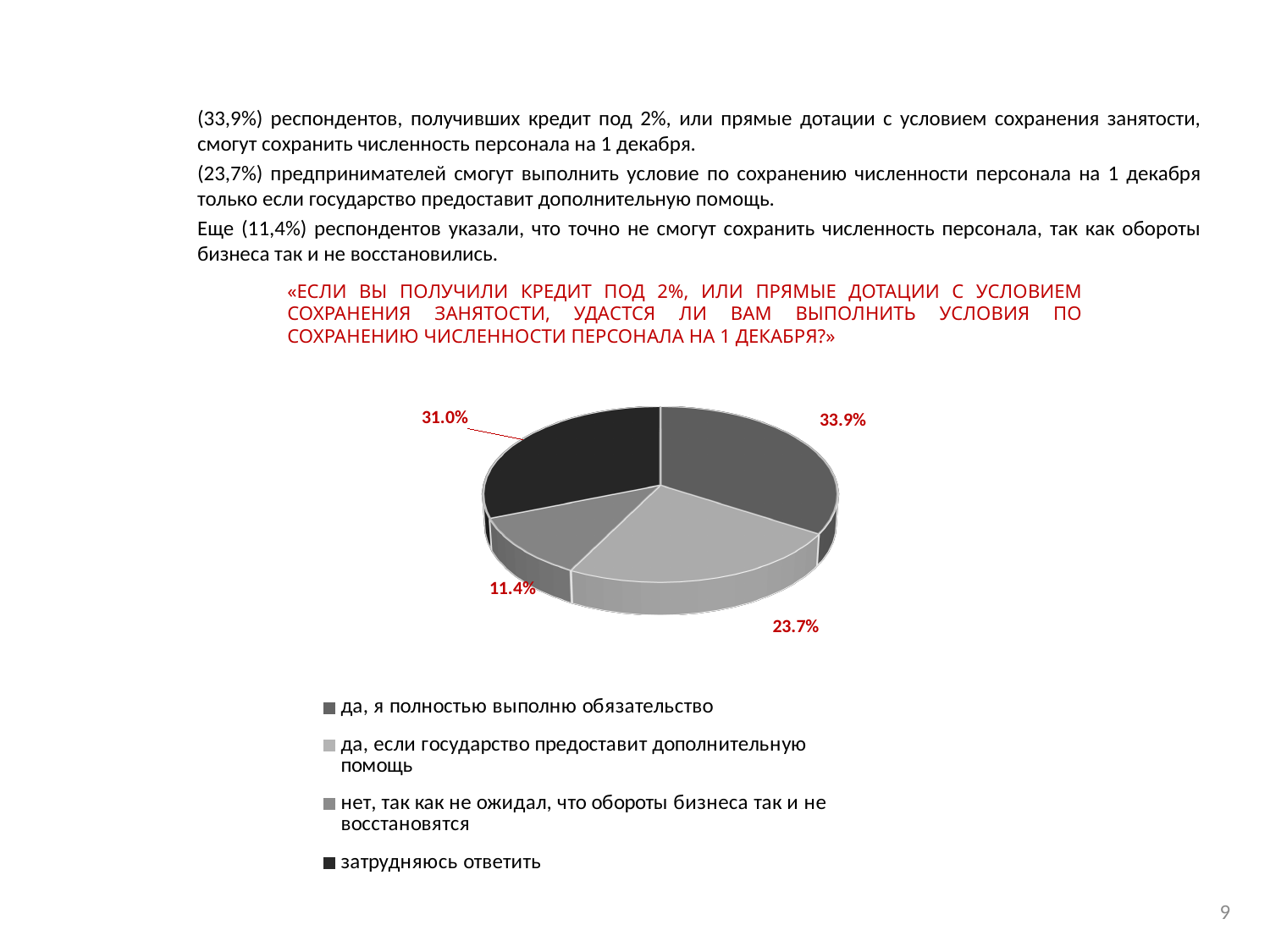
What share of respondents answered "затрудняюсь ответить"? 31.0% How many slices does the pie chart have? 4 Which answer option has the smallest slice of the pie? нет, так как не ожидал, что обороты бизнеса так и не восстановятся How many entries does the legend list? 4 What is the difference in percentage points between the "да, я полностью выполню обязательство" slice and the "затрудняюсь ответить" slice? 2.9 What kind of chart is shown on the slide? pie chart What share of respondents answered "да, если государство предоставит дополнительную помощь"? 23.7% Which answer option has the largest slice of the pie? да, я полностью выполню обязательство What share of respondents answered "нет, так как не ожидал, что обороты бизнеса так и не восстановятся"? 11.4% Which is larger: the share for "да, если государство предоставит дополнительную помощь" or the share for "затрудняюсь ответить"? затрудняюсь ответить What share of respondents answered "да, я полностью выполню обязательство"? 33.9% What is the combined share of the two "да" answer options? 57.6%